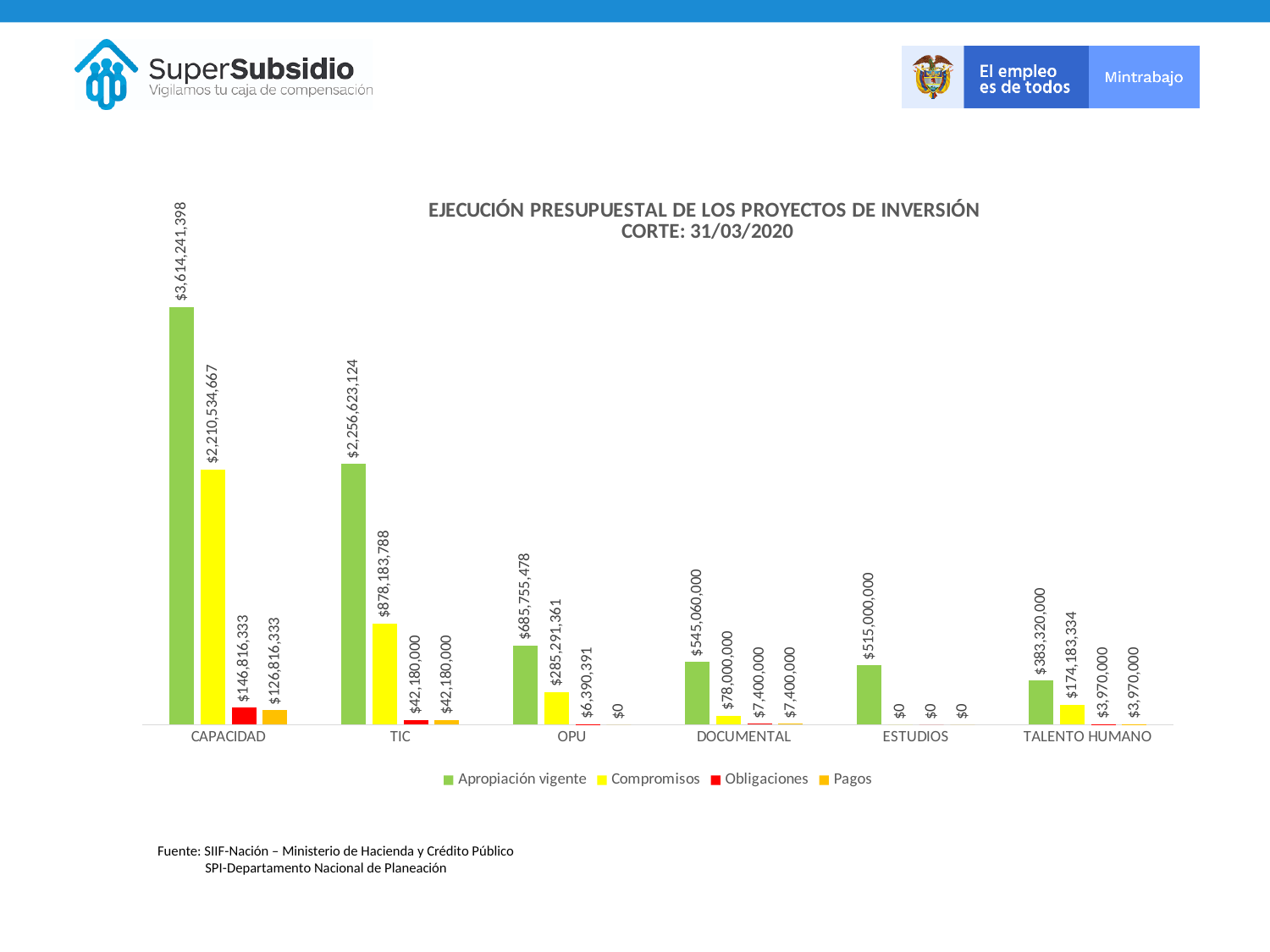
What is the Compromisos value for TIC? $878,183,788 How many categories are shown on the x axis? 6 Which has the larger Compromisos value, CAPACIDAD or TIC? CAPACIDAD What cut-off date (corte) is given in the chart title? 31/03/2020 What kind of chart is shown on the slide? Bar chart How many series does the legend list? 4 What is the Obligaciones value for DOCUMENTAL? $7,400,000 Which category has the lowest Apropiación vigente? TALENTO HUMANO What is the difference between Obligaciones and Pagos for CAPACIDAD? $20,000,000 What is the Pagos value for OPU? $0 What is the Apropiación vigente value for CAPACIDAD? $3,614,241,398 Which category has the highest Apropiación vigente? CAPACIDAD